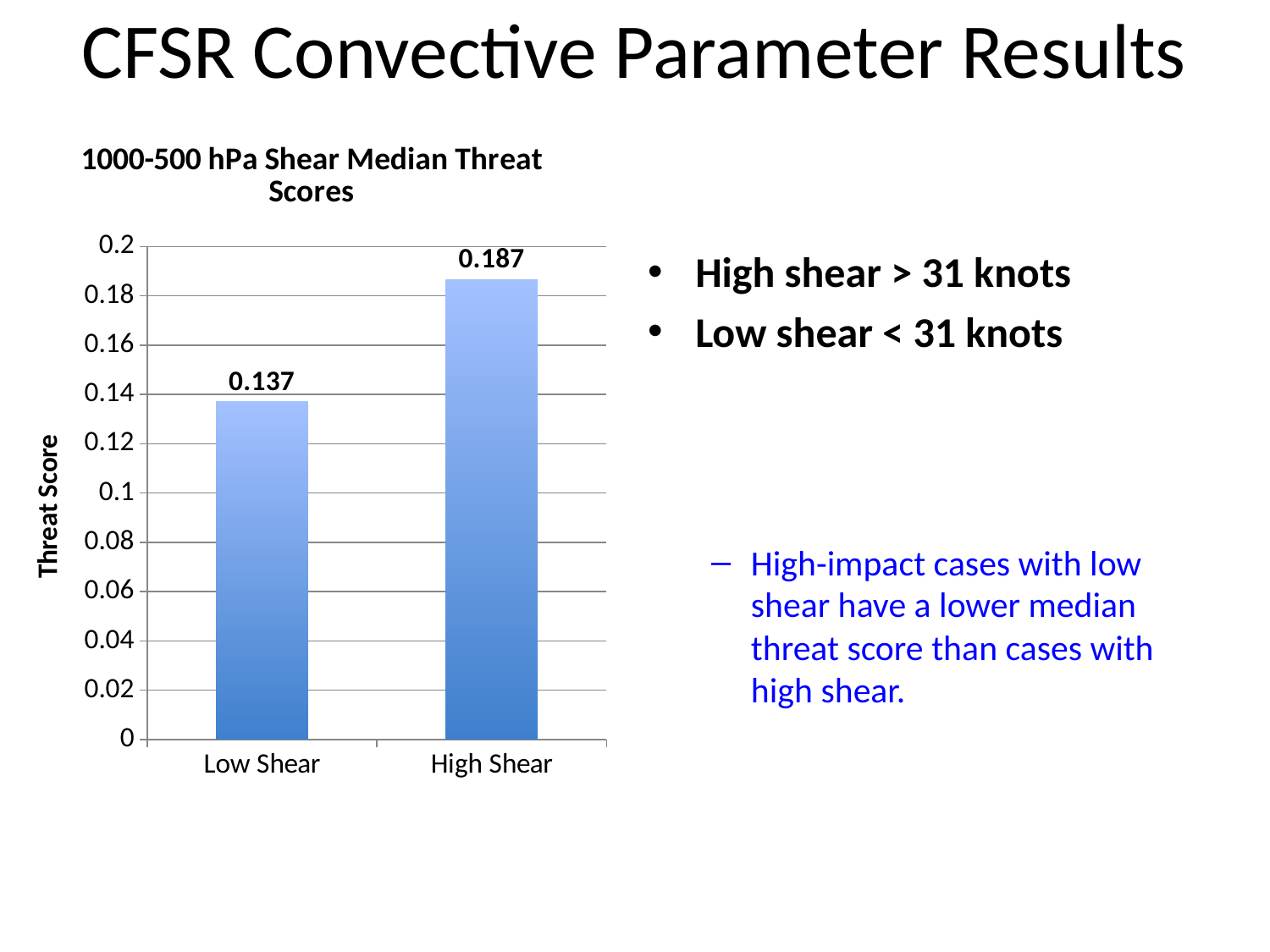
Which category has the lowest median threat score? Low Shear What is the median threat score for Low Shear? 0.137 What is the median threat score for High Shear? 0.187 What is the label of the vertical axis of the chart? Threat Score What kind of chart is shown on the slide? bar chart Is the value for High Shear greater or less than 0.18? greater Which is larger, the threat score for Low Shear or for High Shear? High Shear Is the value for Low Shear greater or less than 0.14? less What is the title of the chart? 1000-500 hPa Shear Median Threat Scores What is the difference between the High Shear and Low Shear median threat scores? 0.050 Which category has the highest median threat score? High Shear How many categories are shown on the x axis of the chart? 2